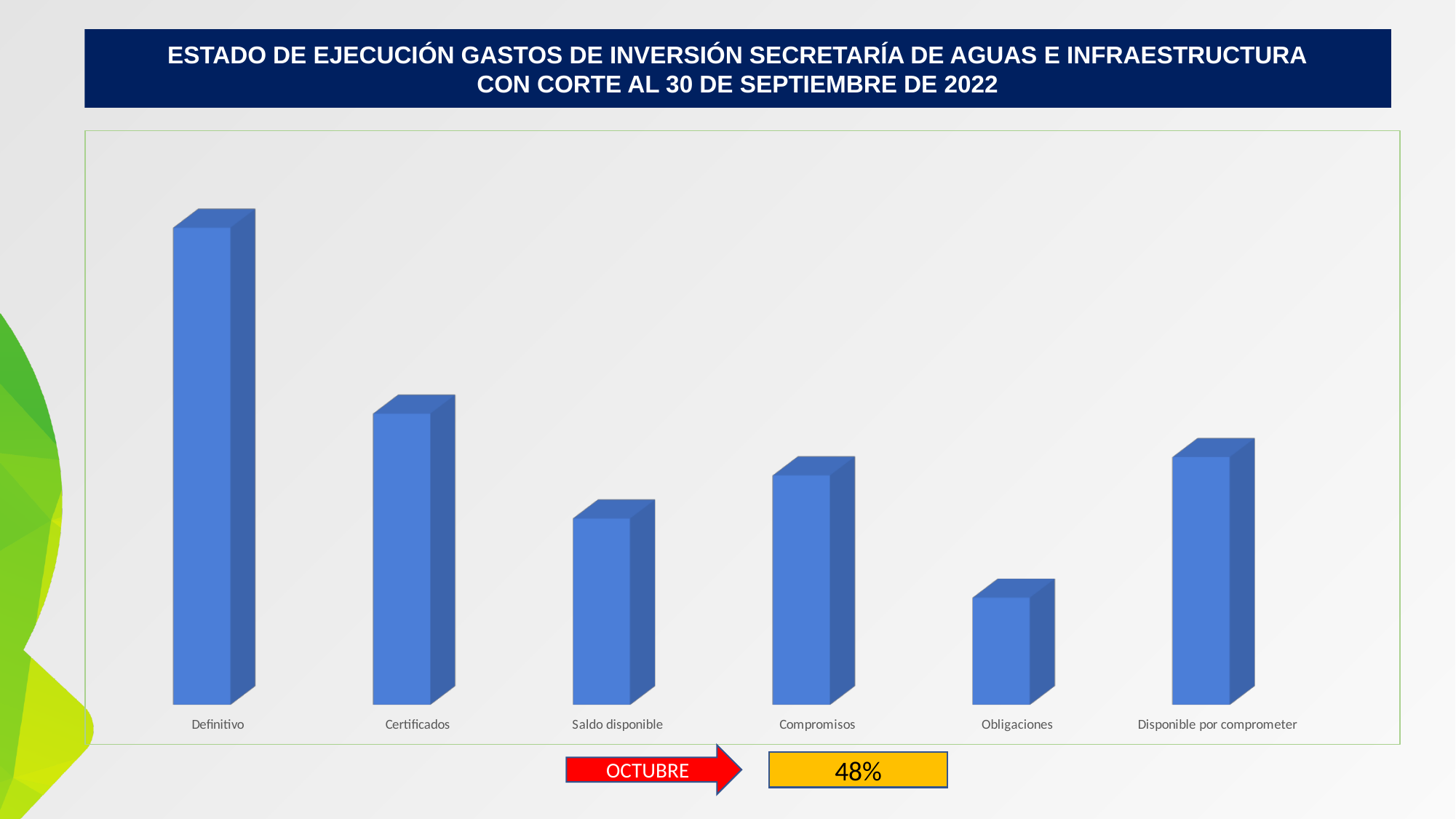
Which bar is taller, Saldo disponible or Obligaciones? Saldo disponible What percentage is shown in the yellow box below the chart? 48% How many categories (bars) does the chart show? 6 What kind of chart is shown on the slide? Bar chart Which category has the shortest bar in the chart? Obligaciones What is the label of the last (rightmost) category on the x axis? Disponible por comprometer Which bar is taller, Definitivo or Saldo disponible? Definitivo Which category has the tallest bar in the chart? Definitivo Which bar is taller, Certificados or Disponible por comprometer? Certificados